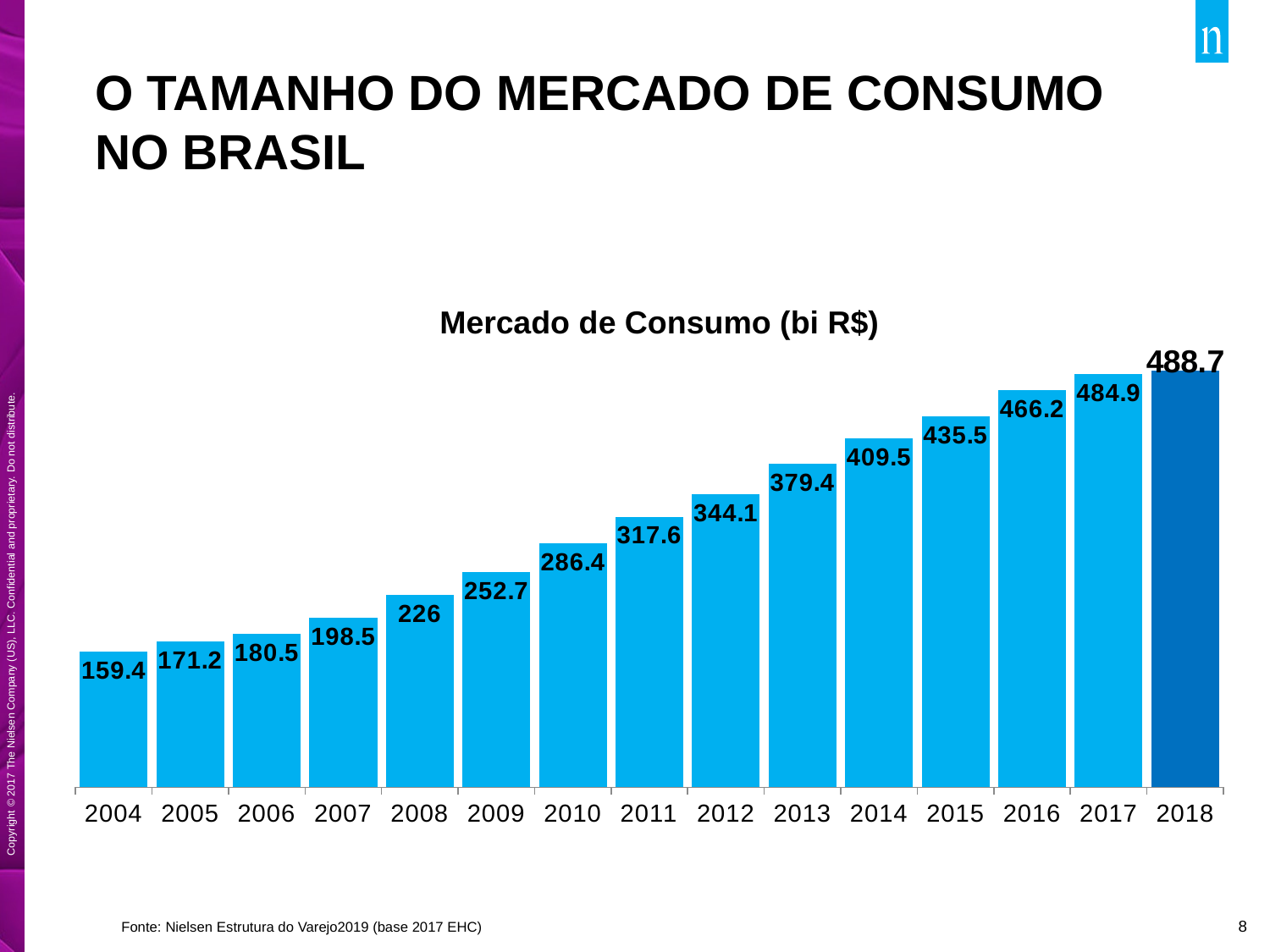
Which year has the highest value in the chart? 2018 What is the title of the chart? Mercado de Consumo (bi R$) What is the value for 2018 in the chart? 488.7 What kind of chart is shown on the slide? Bar chart Do the values rise or fall from 2004 to 2018? Rise What is the difference between the values for 2013 and 2012? 35.3 How many years are shown on the x axis of the chart? 15 What is the value for 2004 in the chart? 159.4 What is the difference between the values for 2018 and 2004? 329.3 Which is larger, the value for 2008 or the value for 2009? 2009 Which year has the lowest value in the chart? 2004 What is the value for 2010 in the Mercado de Consumo (bi R$) chart? 286.4